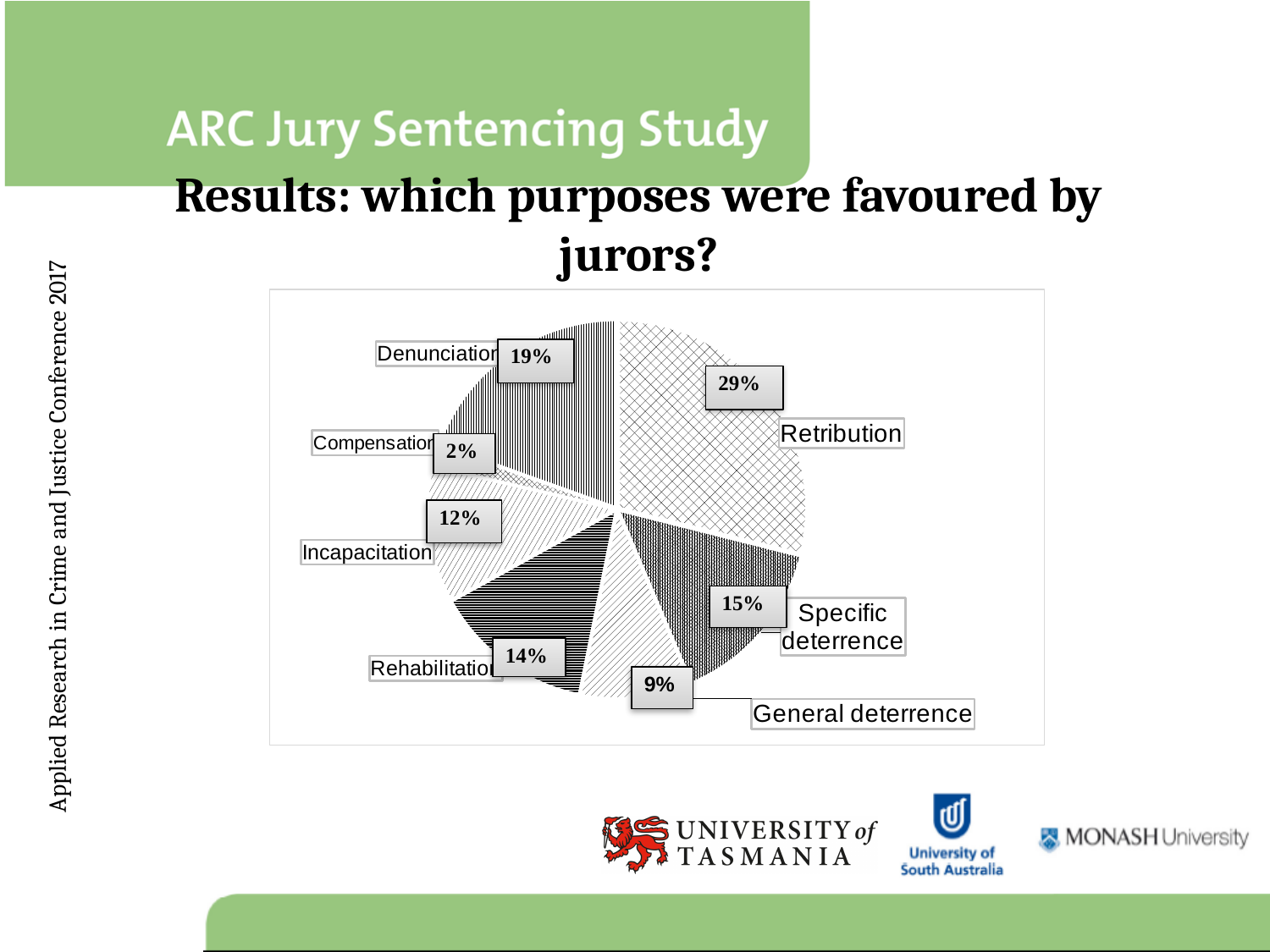
What is the difference in percentage points between Retribution and Denunciation? 10 Which sentencing purpose has the largest share of the pie? Retribution Which sentencing purpose has the smallest share of the pie? Compensation Which has a larger share, Incapacitation or Rehabilitation? Rehabilitation What percentage is shown for Specific deterrence? 15% What kind of chart is shown on the slide? Pie chart What percentage is shown for Denunciation? 19% What percentage is shown for Rehabilitation? 14% What share of the pie does Retribution have? 29% How many slices does the pie chart have? 7 What is the combined share of Specific deterrence and General deterrence? 24% What percentage is shown for General deterrence? 9%